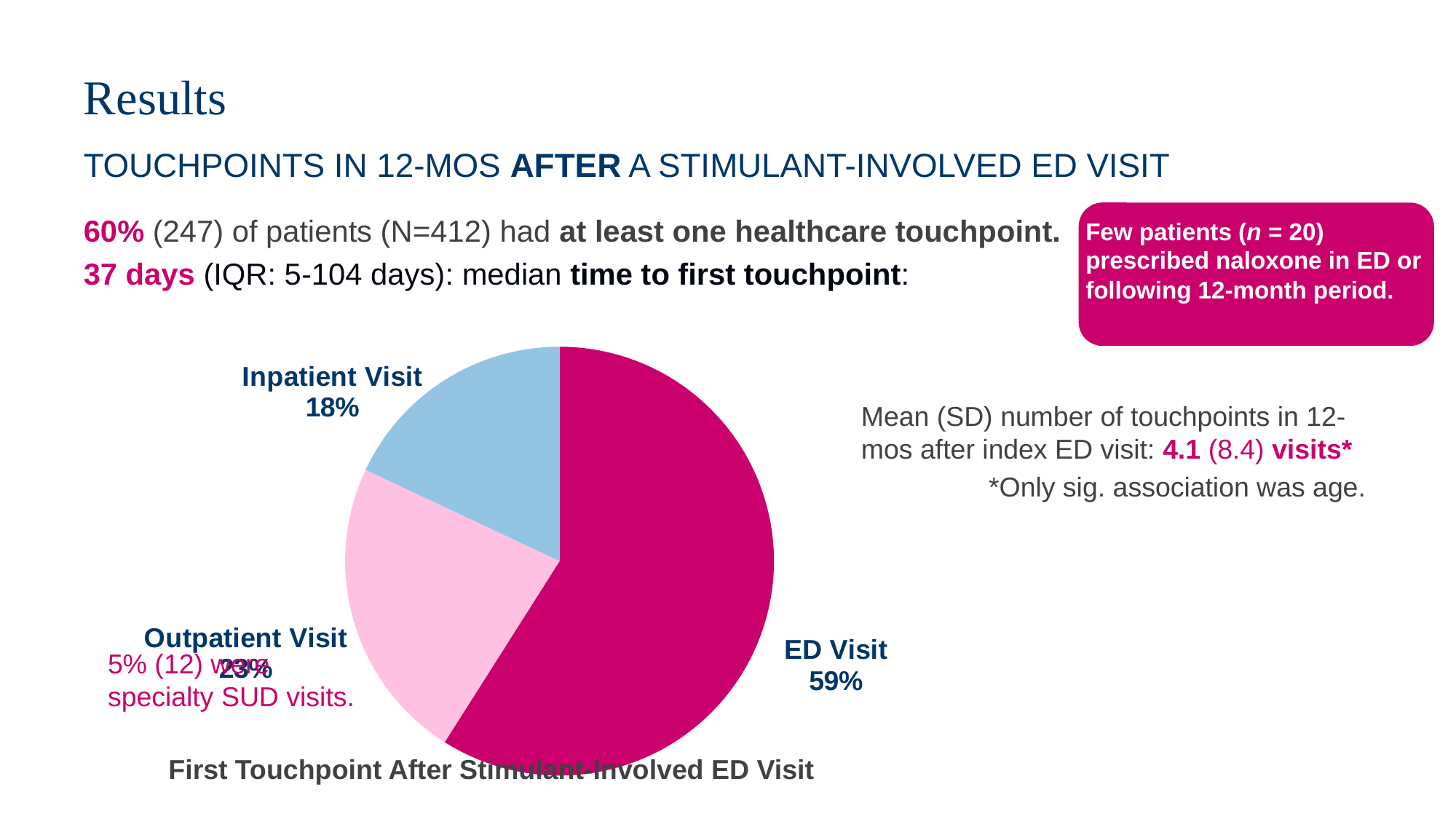
Which category has the smallest slice of the pie? Inpatient Visit What colour is the ED Visit slice? magenta What is the difference in percentage points between the ED Visit slice and the Inpatient Visit slice? 41 What type of chart is shown on the slide? pie chart Which is larger, the ED Visit slice or the Outpatient Visit slice? ED Visit What share of the pie does Inpatient Visit represent? 18% How many slices does the pie chart have? 3 Which category has the largest slice of the pie? ED Visit What share of the pie does ED Visit represent? 59% What is the title of the pie chart? First Touchpoint After Stimulant-Involved ED Visit Is the ED Visit slice greater or less than half of the pie? greater